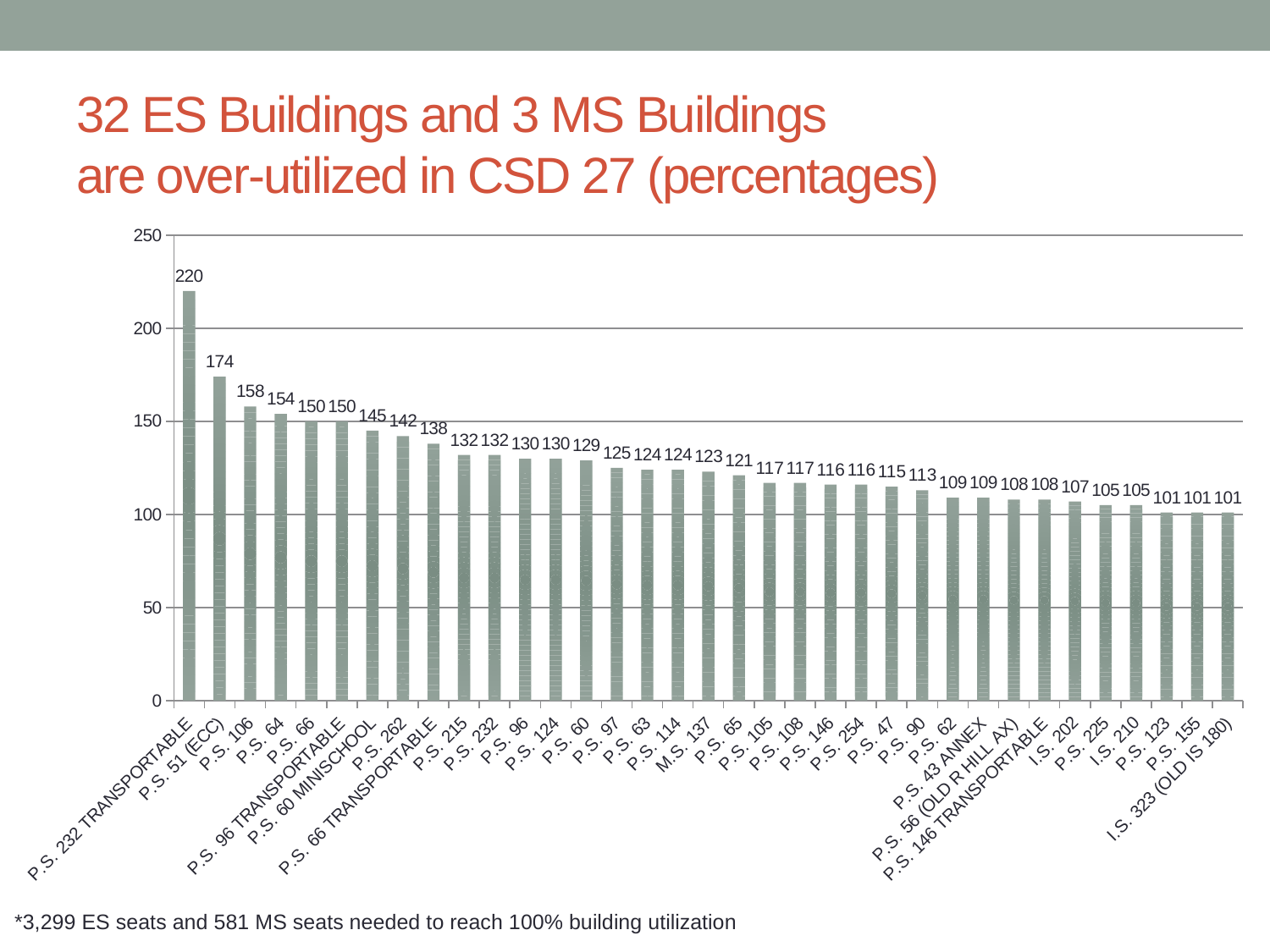
What is the value for I.S. 202? 107 How many buildings (bars) are shown on the chart? 35 What is the value for M.S. 137? 123 Which is larger, the value for P.S. 106 or the value for P.S. 262? P.S. 106 Which building has the highest value? P.S. 232 TRANSPORTABLE What is the value for P.S. 232 TRANSPORTABLE? 220 What is the difference between the values for P.S. 232 TRANSPORTABLE and P.S. 51 (ECC)? 46 Is the value for P.S. 60 MINISCHOOL greater or less than 100? greater Do the values rise or fall moving from left to right along the x axis? Fall What is the lowest value shown on the chart? 101 What kind of chart is shown on the slide? Bar chart What is the value for P.S. 51 (ECC)? 174